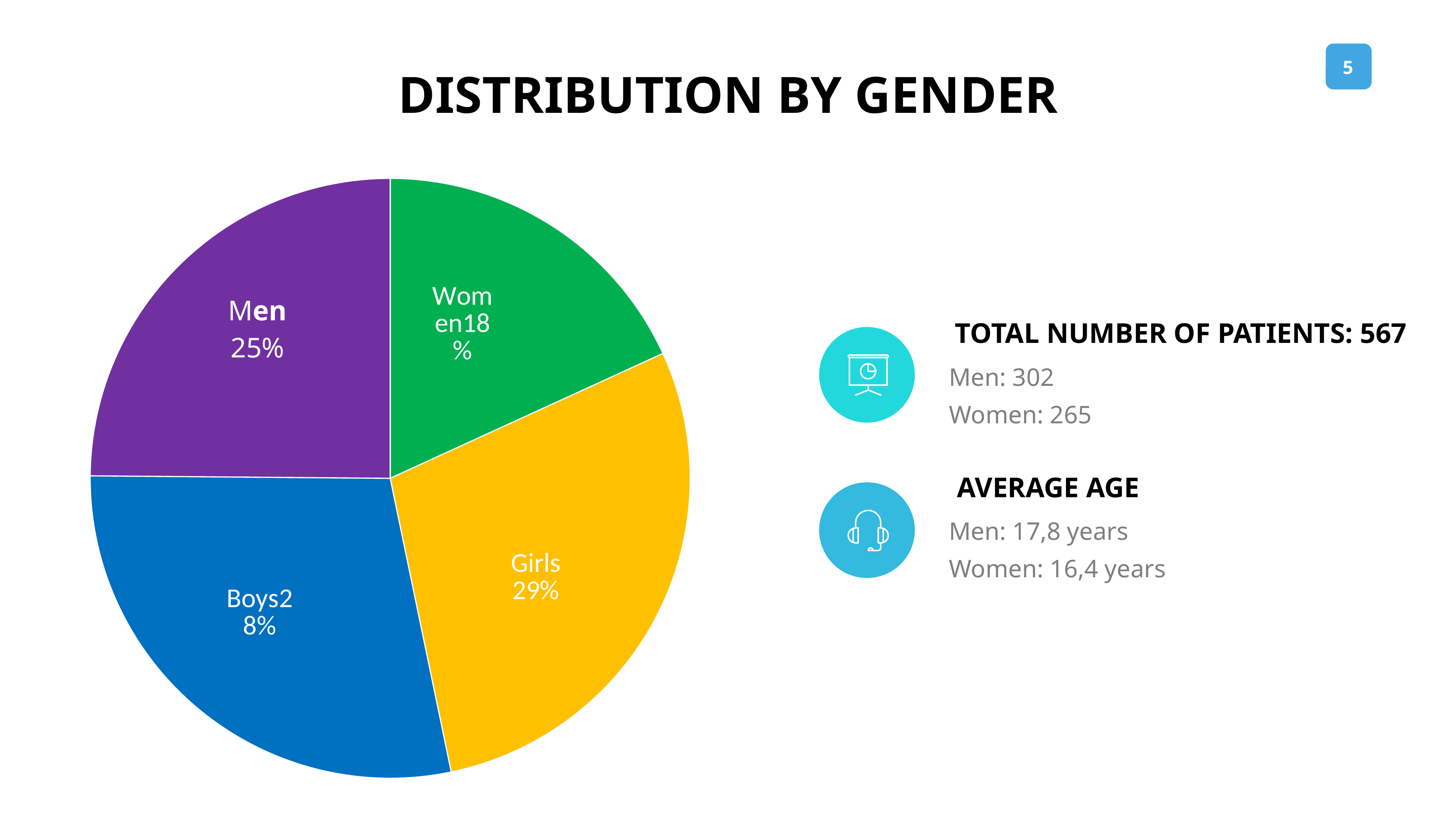
Which category has the smallest slice of the pie? Women What share of the pie does the Men slice represent? 25% How many percentage points larger is the Girls slice than the Men slice? 4 What percentage is shown for the Girls slice? 29% What percentage is shown for the Boys slice? 28% Which category has the largest slice of the pie? Girls What type of chart is shown on the slide? Pie chart What colour is the Girls slice? Yellow What is the title of the slide containing the chart? DISTRIBUTION BY GENDER How many slices does the pie chart have? 4 Which slice is larger, Men or Women? Men What percentage is shown for the Women slice? 18%